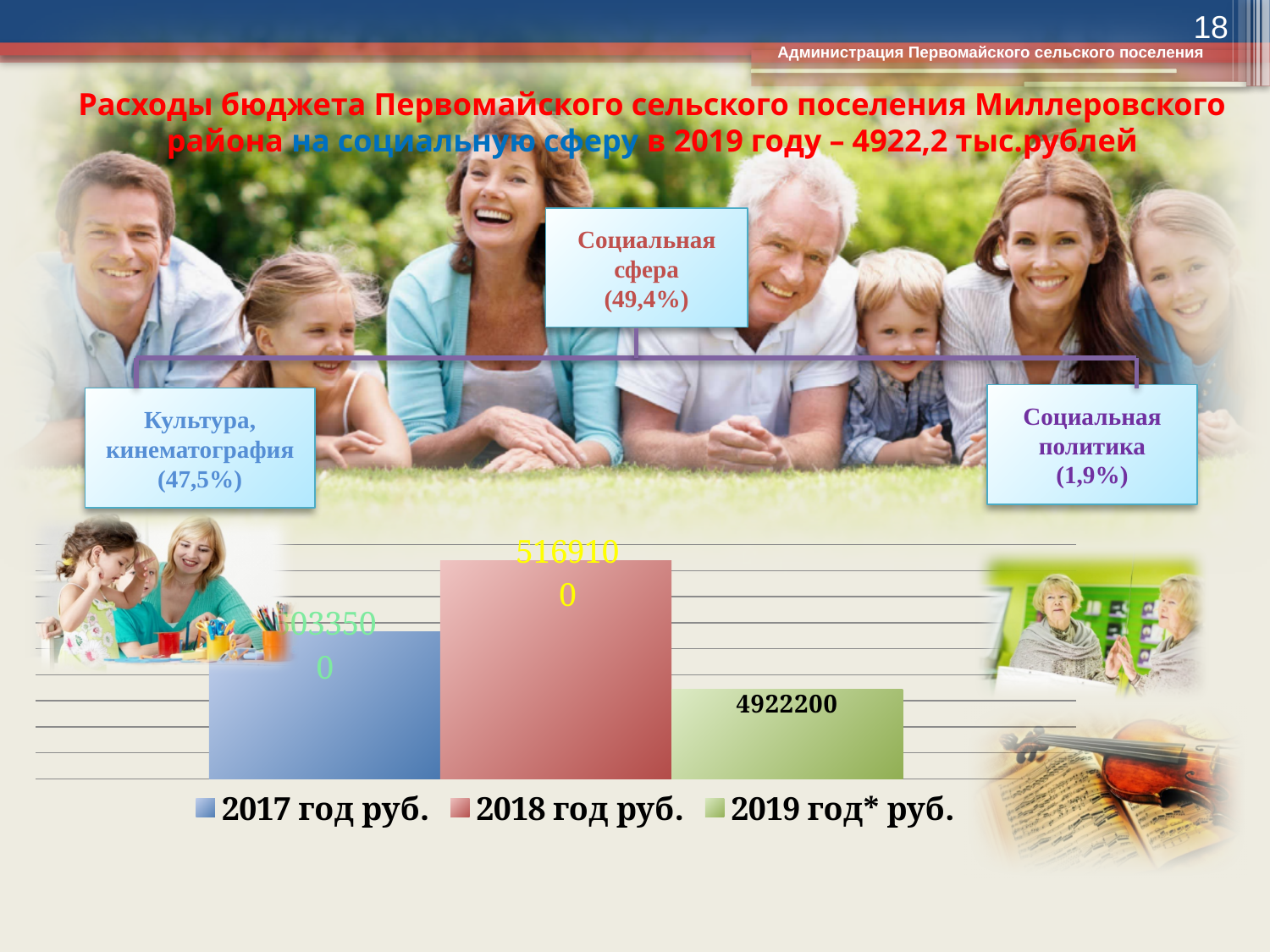
How many series does the chart legend list? 3 How many bars are plotted in the chart? 3 Which year has the highest bar in the chart? 2018 год руб. What is the value shown for 2018 год руб. in the bar chart? 5169100 What is the value shown for 2019 год* руб. in the bar chart? 4922200 Which is larger in the chart: the value for 2017 год руб. or for 2018 год руб.? 2018 год руб. Does the value rise or fall from 2018 год руб. to 2019 год* руб. in the chart? fall What colour is the bar for 2019 год* руб. in the chart? green What kind of chart is shown on the slide? bar chart What is the difference between the values for 2018 год руб. and 2019 год* руб. in the chart? 246900 Which year has the lowest bar in the chart? 2019 год* руб. Which is larger in the chart: the value for 2018 год руб. or for 2019 год* руб.? 2018 год руб.